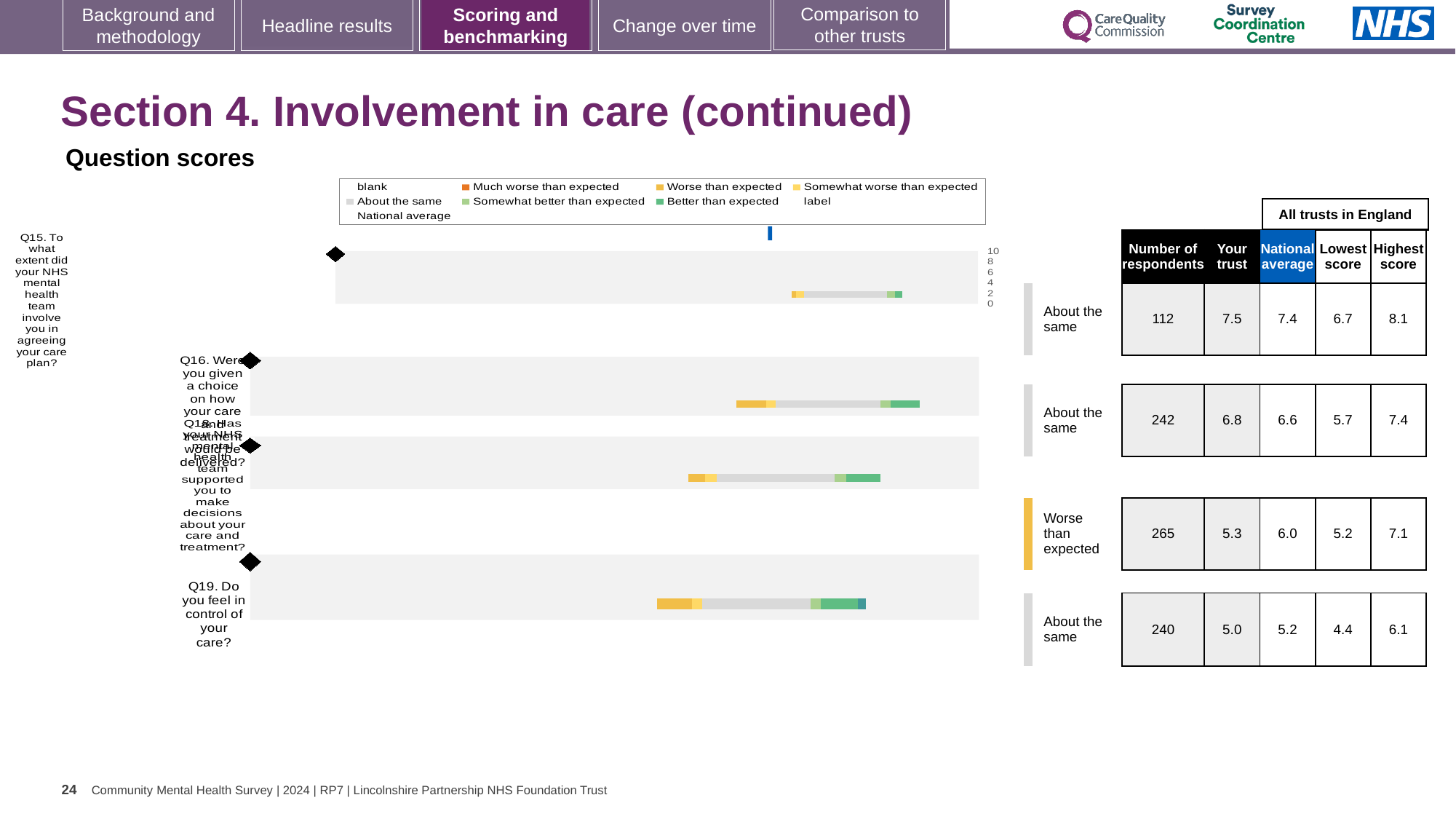
What benchmark category is shown for Q18? Worse than expected Which question has the highest 'Your trust' score? Q15 For Q18, how much higher is the national average than the 'Your trust' score? 0.7 What is the 'Your trust' score for Q15 (To what extent did your NHS mental health team involve you in agreeing your care plan?)? 7.5 What is the highest score among all trusts in England for Q19 (Do you feel in control of your care?)? 6.1 What is the national average score for Q18 (Has your NHS mental health team supported you to make decisions about your care and treatment?)? 6.0 How many questions are plotted on the chart? 4 What kind of chart is used to show the question scores? Bar chart For Q16, which is larger: the 'Your trust' score or the national average? Your trust Which question has the largest number of respondents? Q18 Which question has the lowest 'Your trust' score? Q19 How many respondents answered Q16 (Were you given a choice on how your care and treatment would be delivered?)? 242